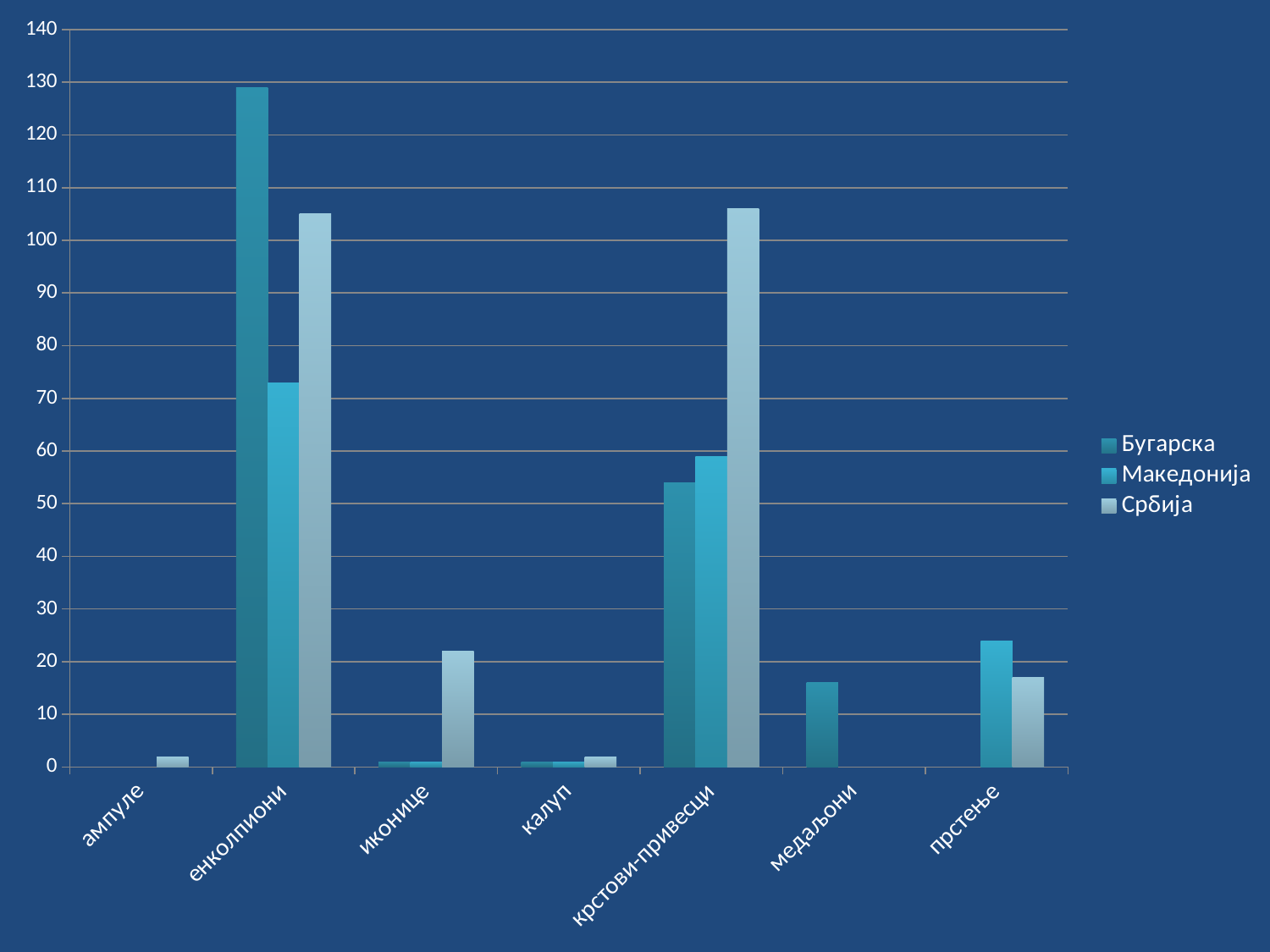
How many series does the legend list? 3 Which series are listed in the legend? Бугарска, Македонија, Србија How many categories are shown on the x axis? 7 What kind of chart is shown on the slide? bar chart Is the value for Бугарска in the енколпиони category greater or less than 120? greater Is the value for Бугарска in the медаљони category greater or less than 20? less Which category has the highest value for the Бугарска series? енколпиони In the прстење category, which is larger: the value for Македонија or for Србија? Македонија In the енколпиони category, which is larger: the value for Бугарска or for Македонија? Бугарска Is the value for Србија in the иконице category greater or less than 10? greater